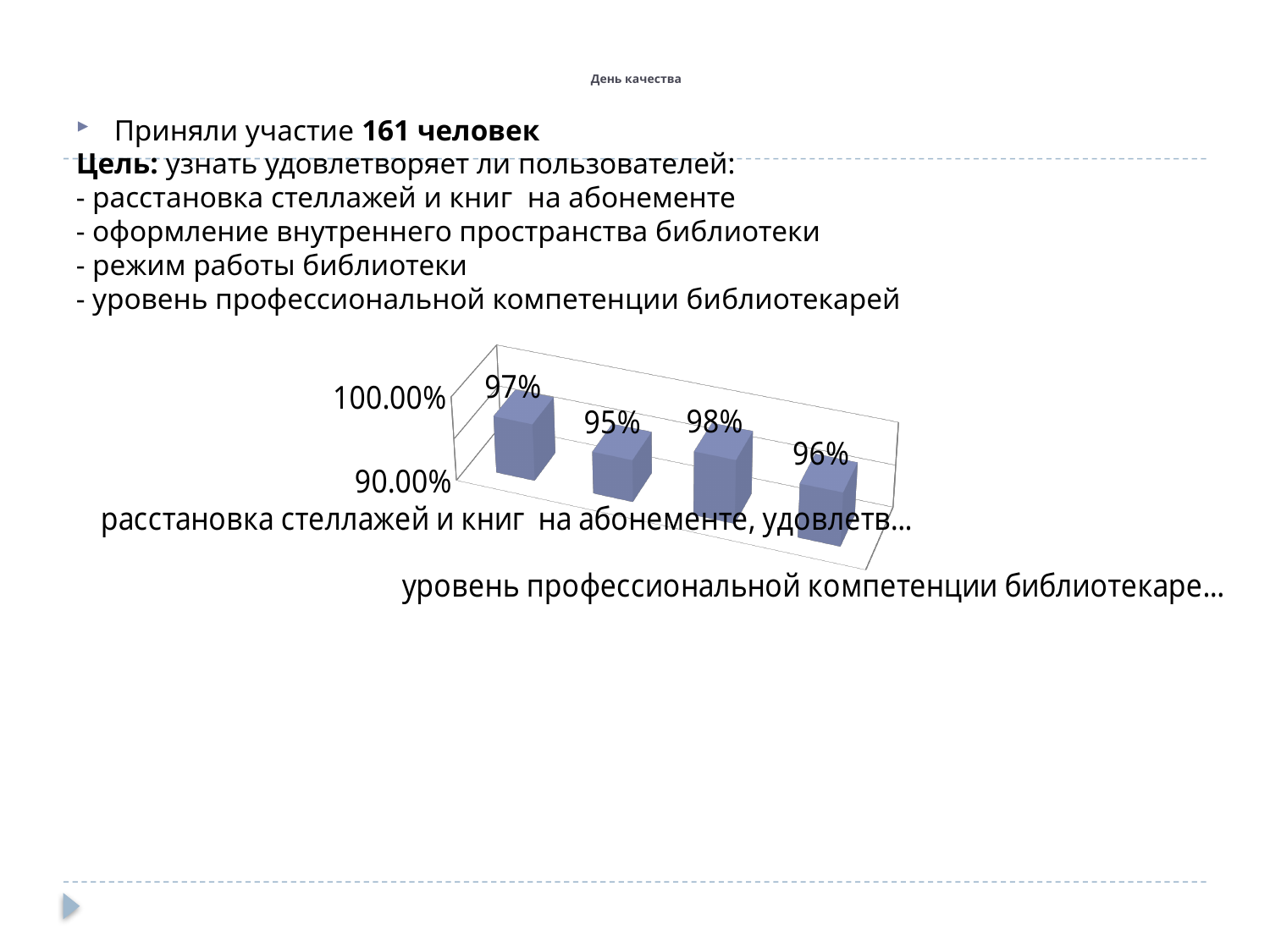
What is the value of the third bar from the left? 98% Which is larger: the value for 'расстановка стеллажей и книг на абонементе' or the value for 'уровень профессиональной компетенции библиотекарей'? расстановка стеллажей и книг на абонементе Which bar has the highest value? the third bar (98%) What is the value of the first (leftmost) bar, for 'расстановка стеллажей и книг на абонементе'? 97% What is the lowest tick value shown on the vertical axis? 90.00% What type of chart is shown on the slide? bar chart What is the difference between the highest value (98%) and the lowest value (95%)? 3% How many bars are plotted in the chart? 4 What is the value of the last (rightmost) bar, for 'уровень профессиональной компетенции библиотекарей'? 96% Which bar has the lowest value? the second bar (95%) What is the value of the second bar from the left? 95% Is the value of the second bar greater or less than 90.00%? greater